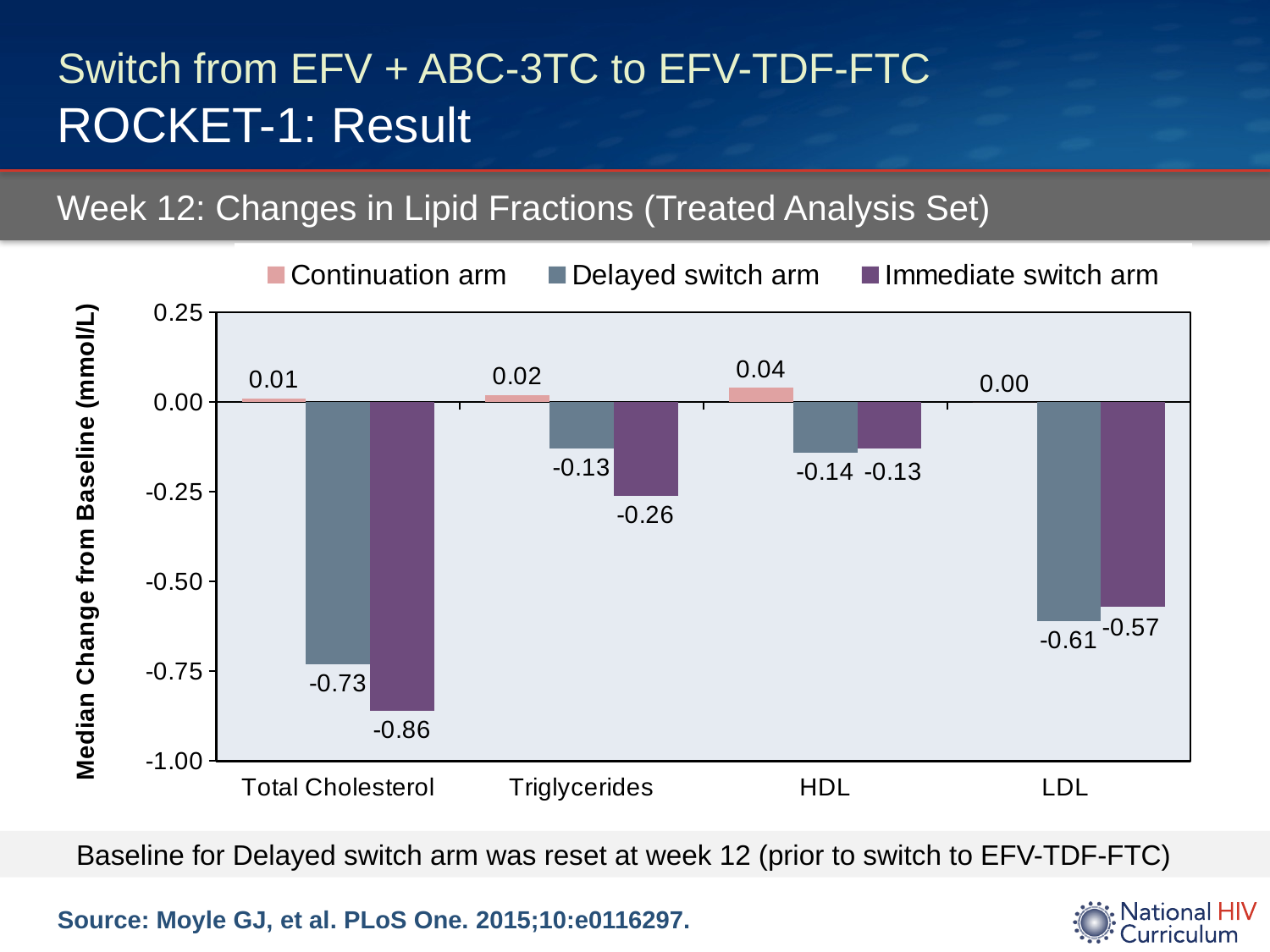
How many lipid fractions are shown on the x axis? 4 What is the label of the y axis? Median Change from Baseline (mmol/L) What is the value for the Continuation arm in HDL? 0.04 Which lipid fraction shows the highest value for the Continuation arm? HDL What is the value for the Delayed switch arm in LDL? -0.61 What is the value for the Immediate switch arm in Triglycerides? -0.26 What kind of chart is shown on the slide? Bar chart Which lipid fraction shows the lowest value for the Immediate switch arm? Total Cholesterol For Triglycerides, which is larger, the Delayed switch arm value or the Immediate switch arm value? Delayed switch arm What is the difference between the Delayed switch arm and Immediate switch arm values for Total Cholesterol? 0.13 What is the median change from baseline for the Immediate switch arm in Total Cholesterol? -0.86 How many series does the legend list? 3